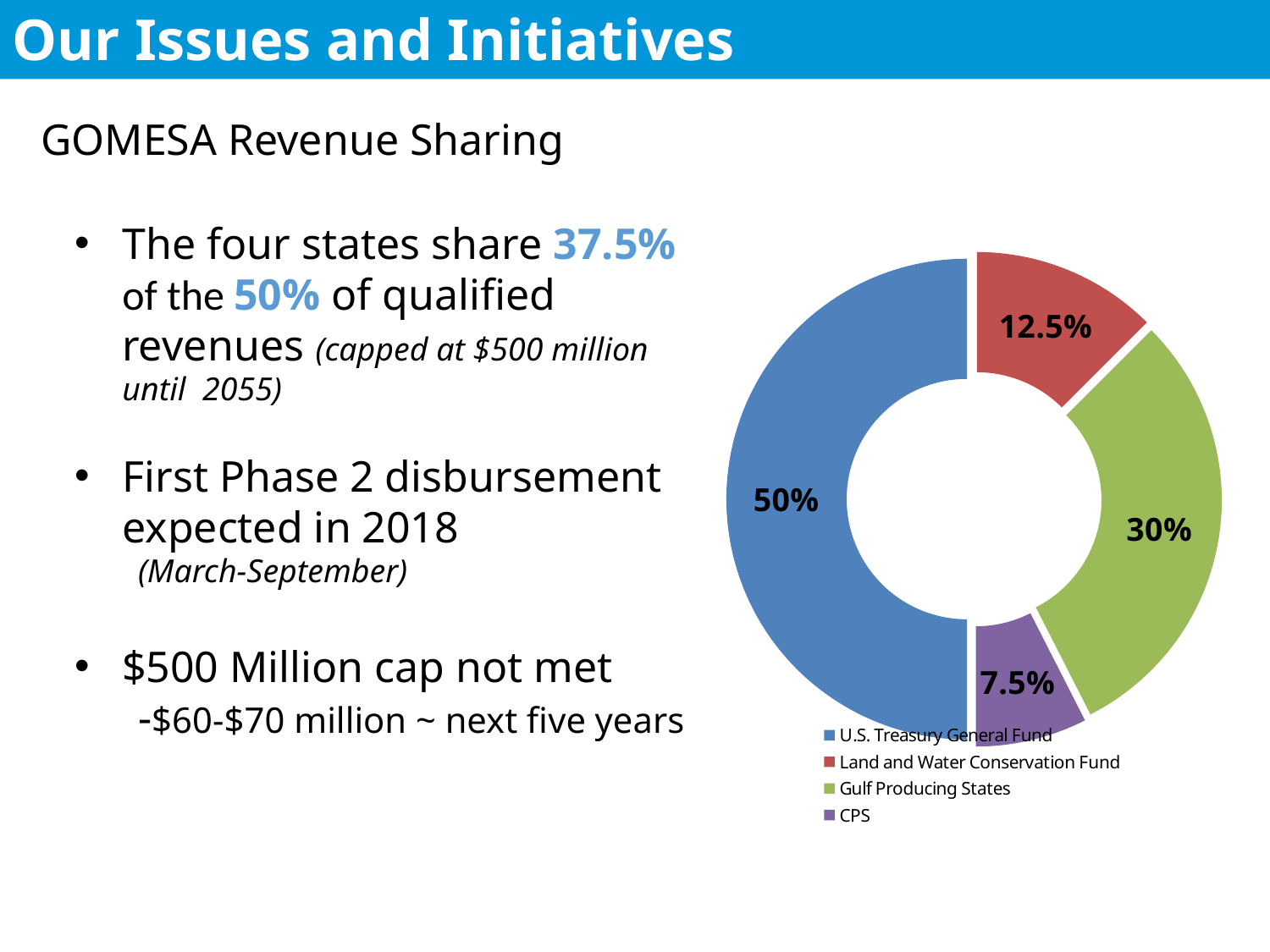
What is the difference in percentage points between the Gulf Producing States share and the Land and Water Conservation Fund share? 17.5 What percentage does the chart show for CPS? 7.5% What type of chart is shown on the slide? Doughnut chart Which is larger: the share for Gulf Producing States or the share for the Land and Water Conservation Fund? Gulf Producing States Which category has the largest share in the chart? U.S. Treasury General Fund What colour represents the U.S. Treasury General Fund in the chart? Blue What is the combined share of Gulf Producing States and CPS? 37.5% What share of the doughnut chart goes to the U.S. Treasury General Fund? 50% What percentage does the chart show for the Land and Water Conservation Fund? 12.5% Which category has the smallest share in the chart? CPS How many categories are shown in the chart? 4 What percentage does the chart show for Gulf Producing States? 30%